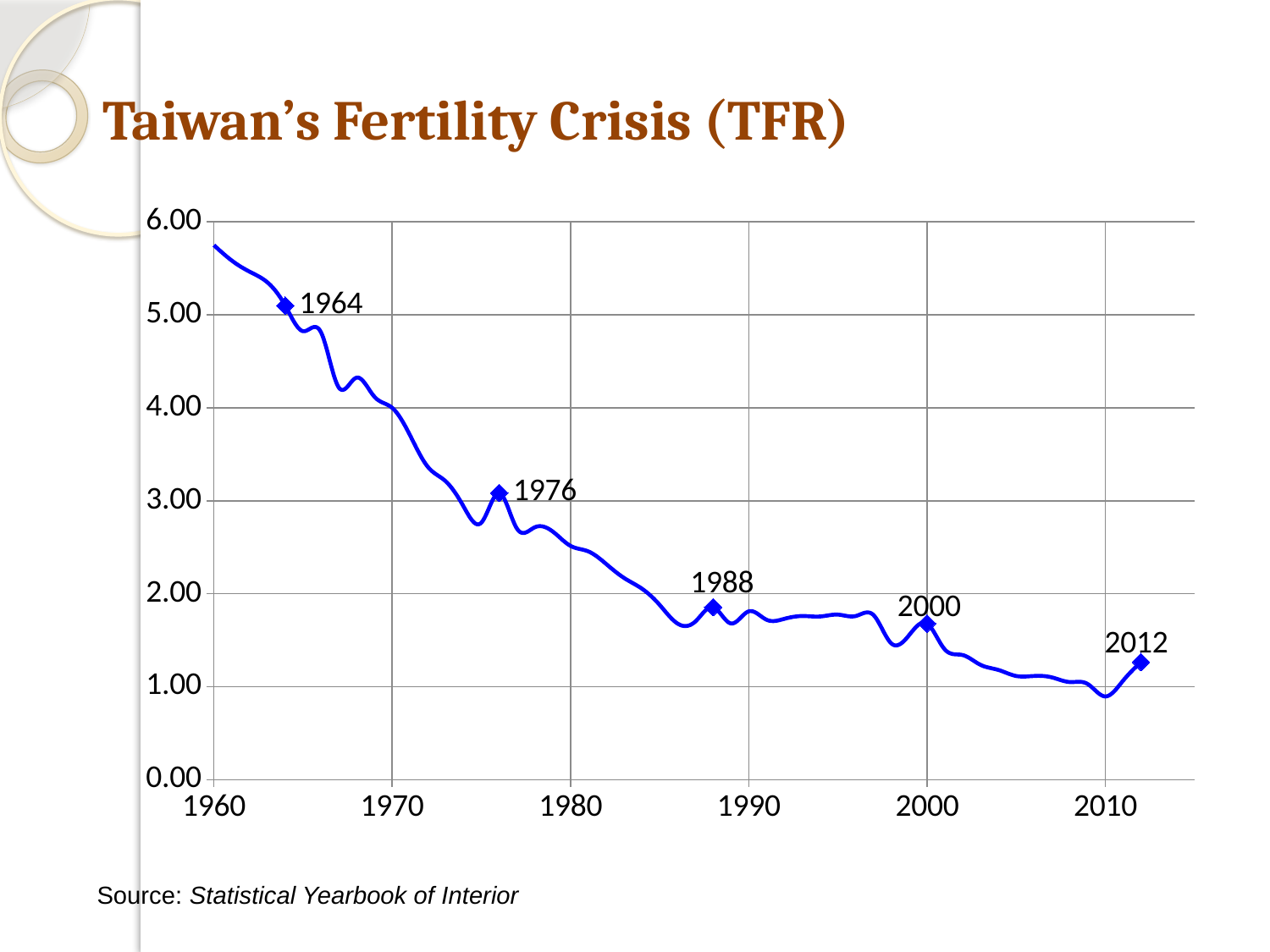
What is the title of the chart? Taiwan's Fertility Crisis (TFR) Is the value for 2000 greater or less than 2.00? less Is the value for 1964 greater or less than 4.00? greater What kind of chart is shown on the slide? line chart What source is cited below the chart? Statistical Yearbook of Interior Which labeled year has the higher value, 1964 or 2012? 1964 How many data points are marked with year labels on the line? 5 Is the value for 2012 greater or less than 1.00? greater Overall, do the values rise or fall from 1960 to 2010 along the x axis? fall Which of the labeled years has the highest value? 1964